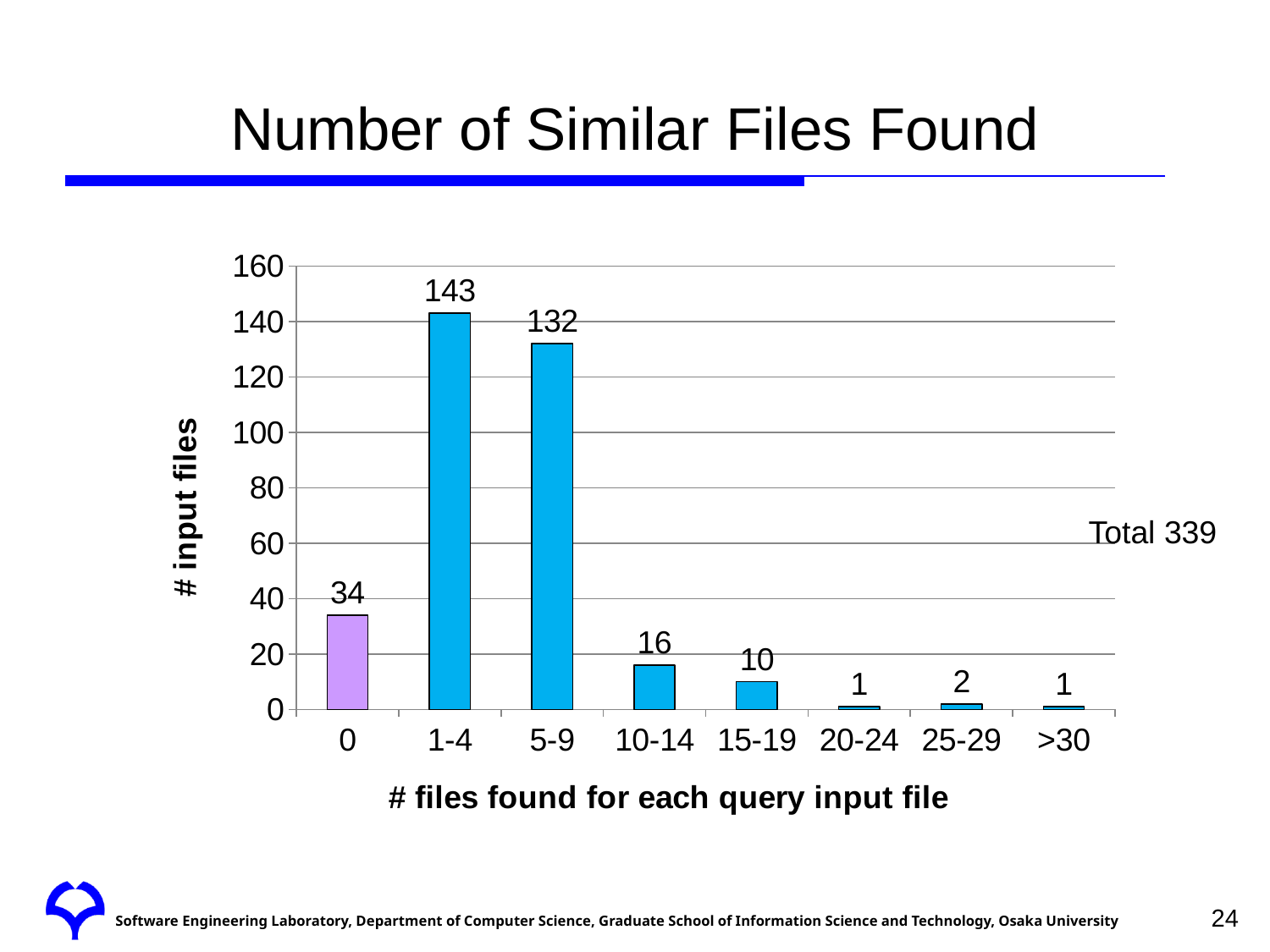
What is the difference between the values for the 0 and 10-14 categories? 18 How many categories are shown on the x axis? 8 What total is printed next to the chart? Total 339 How many input files had 0 similar files found? 34 What is the number of input files for the 1-4 category? 143 What is the number of input files for the 5-9 category? 132 What kind of chart is shown on the slide? bar chart Which is larger, the value for 10-14 or the value for 15-19? 10-14 What is the value for the 15-19 category? 10 What is the difference between the values for the 1-4 and 5-9 categories? 11 Which category has the highest number of input files? 1-4 What is the label of the y axis? # input files